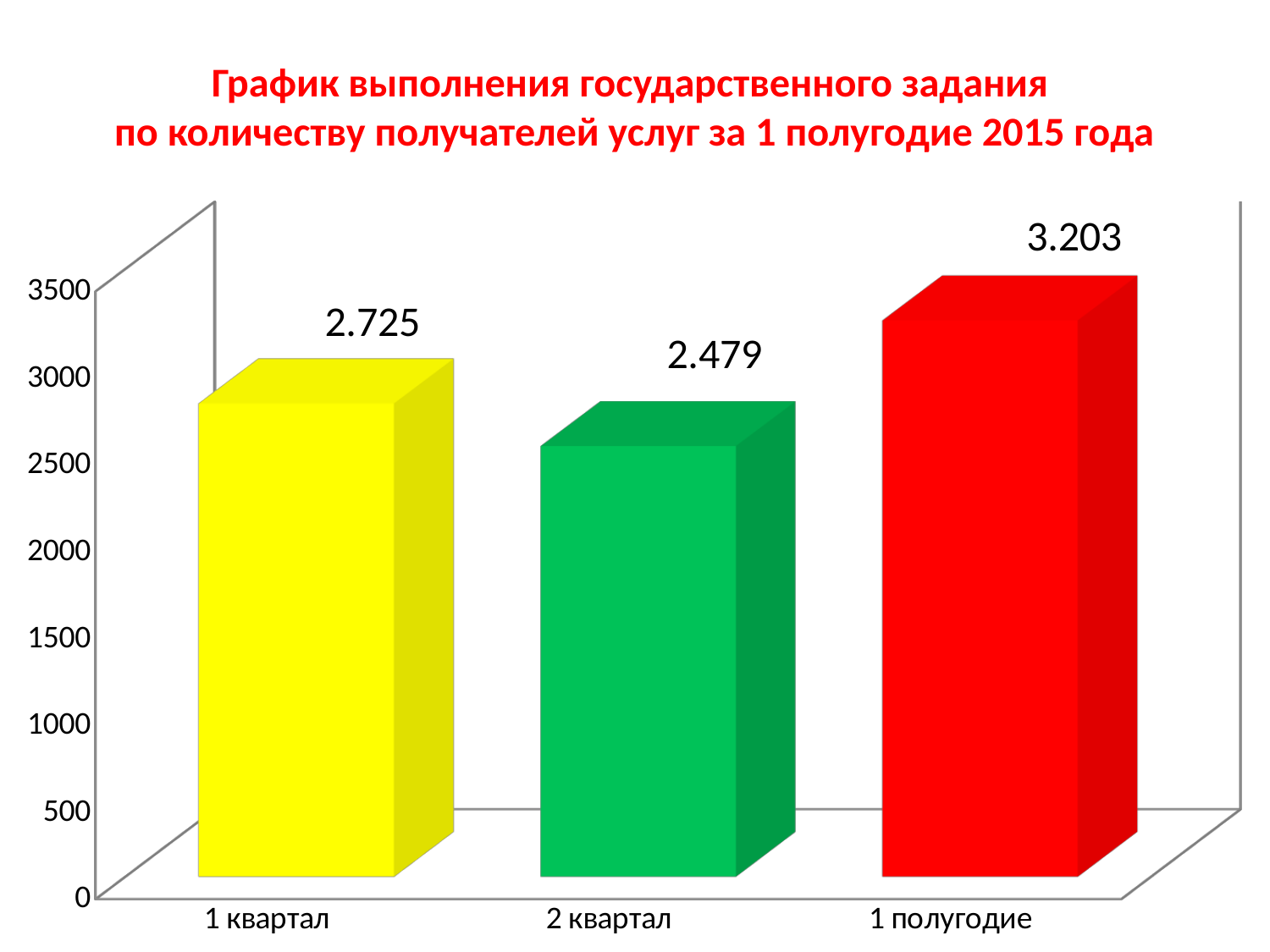
What is the difference between the values for 1 полугодие and 1 квартал? 478 What is the value for 2 квартал? 2.479 Which is larger, the value for 1 квартал or the value for 2 квартал? 1 квартал What is the difference between the values for 1 квартал and 2 квартал? 246 What colour is the bar for 1 полугодие? red What is the value for 1 квартал? 2.725 What is the value for 1 полугодие? 3.203 Which category has the highest value? 1 полугодие How many categories are shown on the x axis? 3 What kind of chart is shown on the slide? bar chart Is the value for 1 полугодие greater or less than 3000? greater Which category has the lowest value? 2 квартал